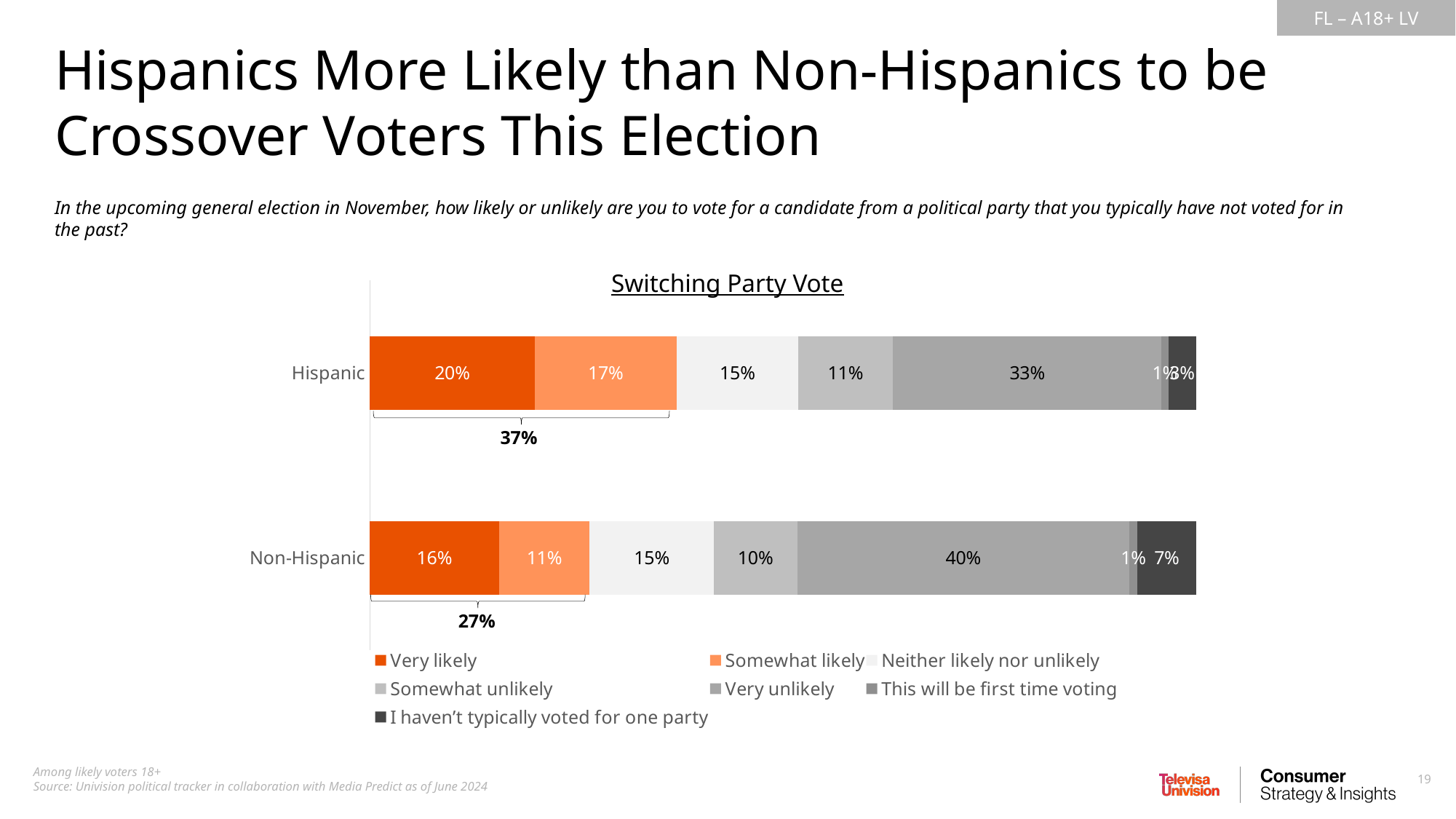
What kind of chart is shown under the title "Switching Party Vote"? Stacked bar chart What is the difference between the Hispanic and Non-Hispanic "Very likely" values? 4% What is the "I haven't typically voted for one party" value for Non-Hispanic voters? 7% What percentage of Hispanic likely voters are "Very likely" to switch their party vote? 20% Which legend entry is shown in the darkest orange colour? Very likely What is the "Somewhat likely" value for Non-Hispanic voters? 11% How many categories (bars) are plotted in the chart? 2 What percentage of Non-Hispanic likely voters are "Very unlikely" to switch their party vote? 40% What combined percentage is shown by the bracket under the Hispanic bar? 37% What combined percentage is shown by the bracket under the Non-Hispanic bar? 27% Which group has the larger "Very unlikely" share, Hispanic or Non-Hispanic? Non-Hispanic How many series does the legend list? 7